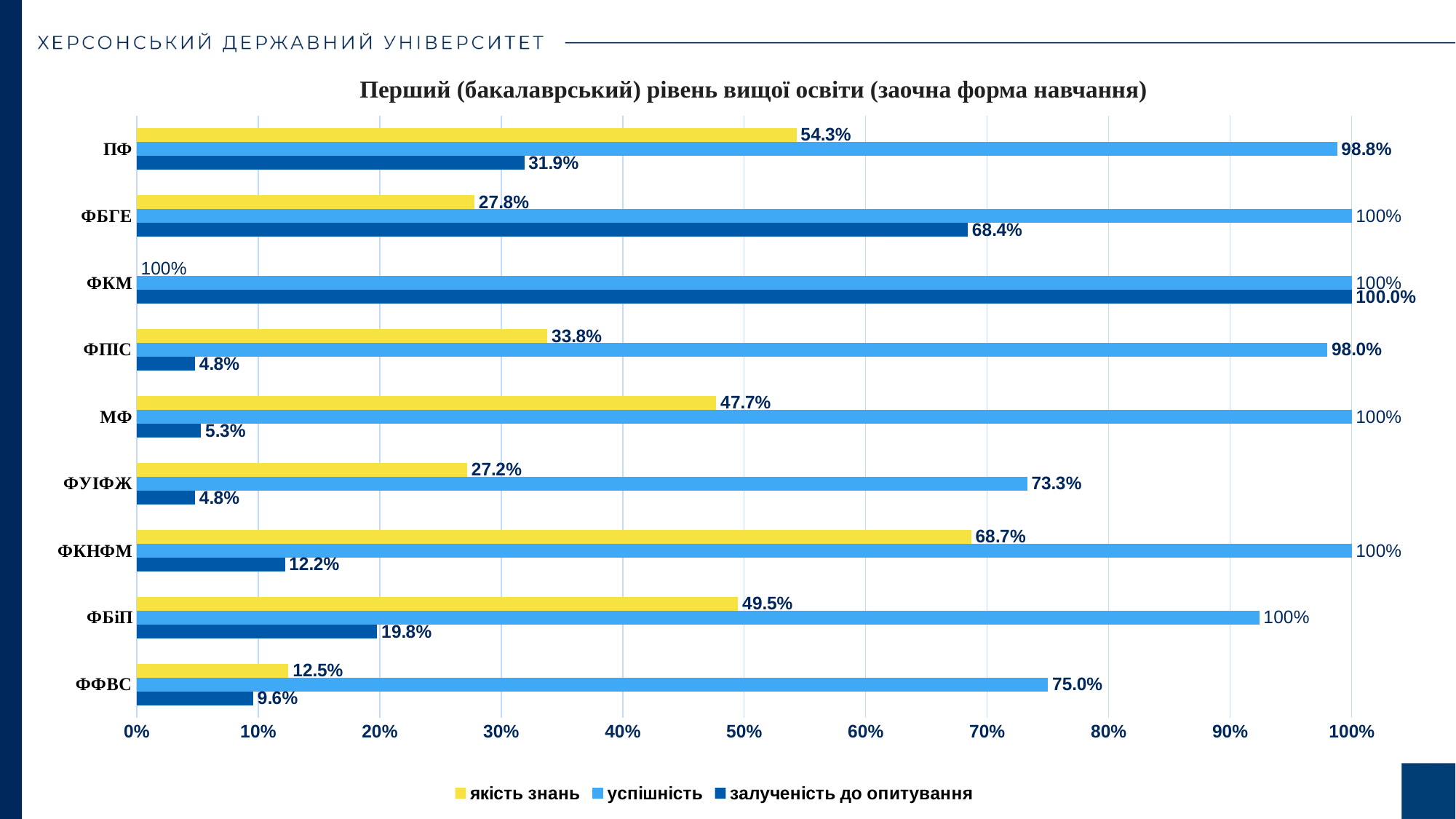
What is the difference between успішність and залученість до опитування for ПФ? 66.9% Is the value of залученість до опитування for ФКНФМ greater or less than 20%? less What kind of chart is shown on the slide? bar chart Which category has the highest value of залученість до опитування? ФКМ How many categories are shown on the chart? 9 Which category has the lowest value of якість знань? ФФВС Which category has the lowest value of успішність? ФУІФЖ How many series does the legend list? 3 Which has a higher value of якість знань, ФКНФМ or ФБіП? ФКНФМ What is the value of якість знань for ПФ? 54.3% What is the value of успішність for ФУІФЖ? 73.3% What is the value of залученість до опитування for ФБГЕ? 68.4%